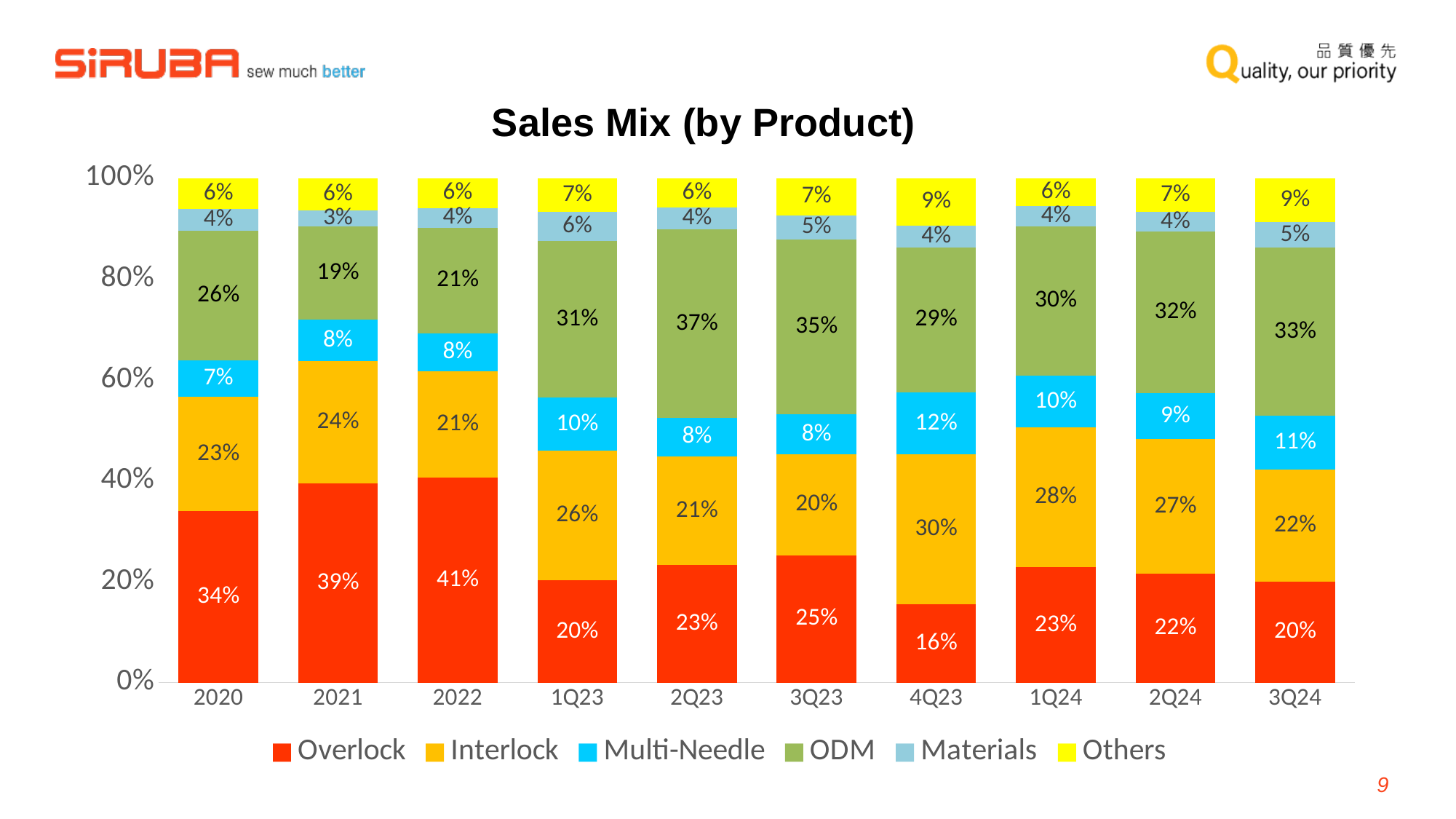
What is the Interlock share in 3Q24? 22% What is the title of the chart? Sales Mix (by Product) How many series does the legend list? 6 What is the Overlock share in 2022? 41% What is the Multi-Needle share in 4Q23? 12% How many periods are shown on the x axis? 10 What is the difference between the ODM share in 2Q23 and the ODM share in 2021? 18% Which period has the lowest Overlock share? 4Q23 Which is larger, the Interlock share in 4Q23 or the Interlock share in 1Q24? 4Q23 What kind of chart is shown on the slide? Stacked bar chart What is the ODM share in 2Q23? 37% Which period has the highest Overlock share? 2022